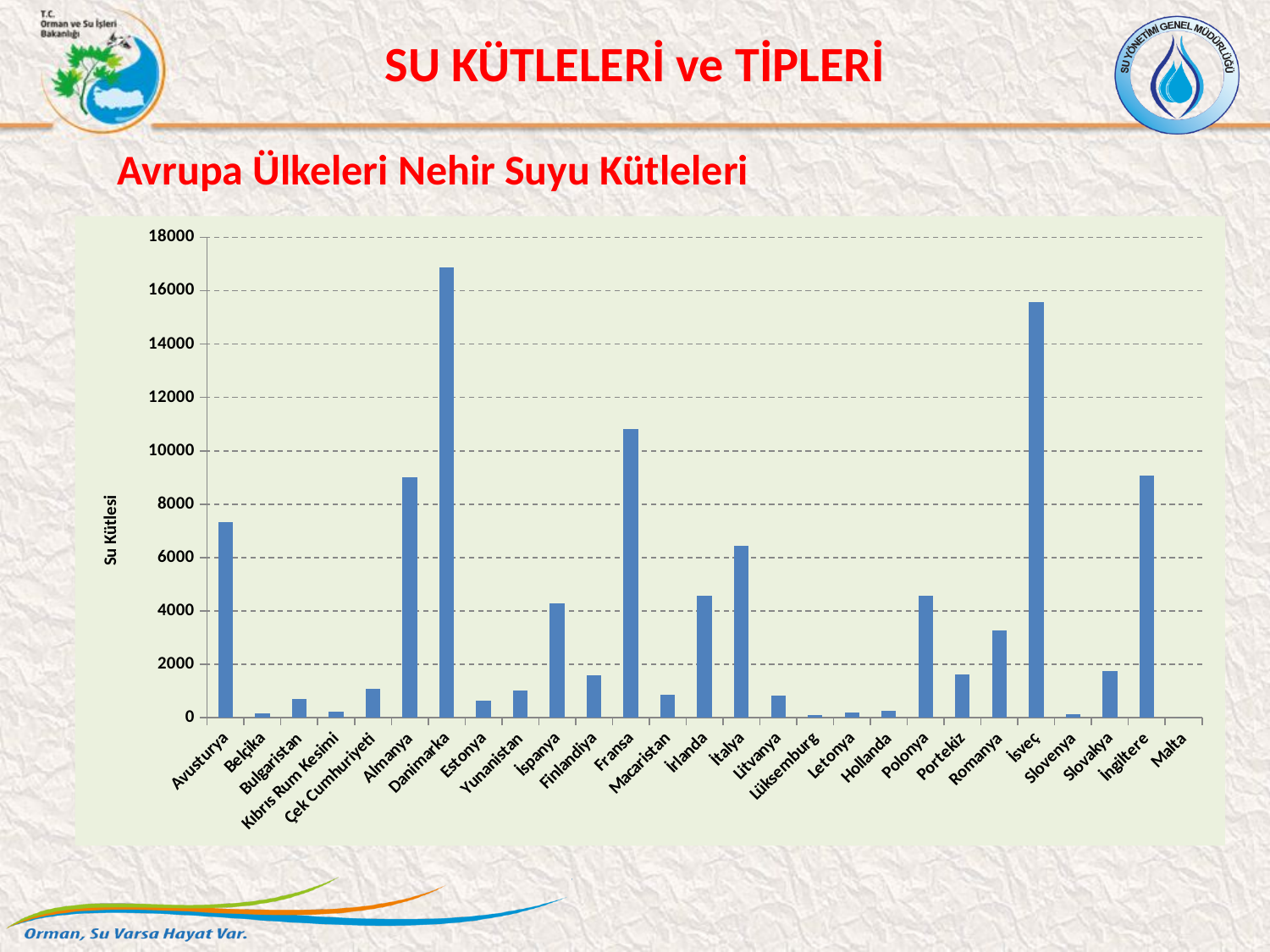
What is the title shown above the chart? Avrupa Ülkeleri Nehir Suyu Kütleleri Is the value for Avusturya greater or less than 6000? greater What is the label of the vertical axis of the chart? Su Kütlesi Which country has the highest river water body value in the chart? Danimarka What kind of chart is shown on the slide? bar chart Which has a larger value, Fransa or Almanya? Fransa Is the value for Danimarka greater or less than 16000? greater Which has a larger value, Danimarka or İsveç? Danimarka How many countries are shown on the x axis of the chart? 27 Is the value for Belçika greater or less than 2000? less